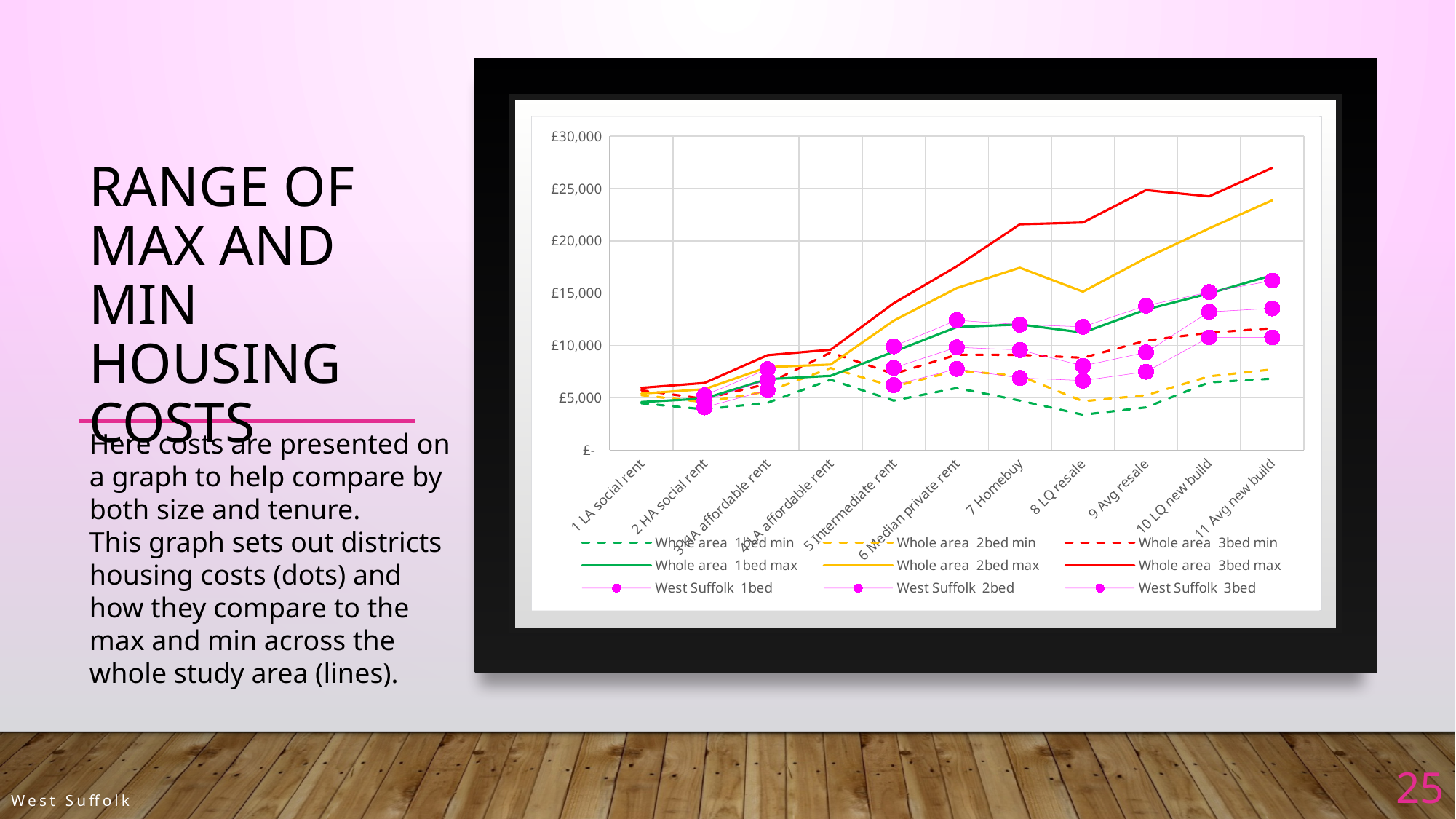
At which category does the Whole area 1bed min line reach its lowest value? 8 LQ resale Is the value of Whole area 3bed max at 7 Homebuy greater or less than £20,000? greater How many series does the chart's legend list? 9 What kind of chart is shown on the slide? Line chart What colour is the Whole area 3bed max line in the chart? Red At which category does the Whole area 3bed max line reach its highest value? 11 Avg new build How many categories are shown along the x axis of the chart? 11 Does the Whole area 3bed max line generally rise or fall from 1 LA social rent to 11 Avg new build? Rise At 11 Avg new build, which is larger: Whole area 3bed max or Whole area 2bed max? Whole area 3bed max Is the value of Whole area 3bed max at 11 Avg new build greater or less than £25,000? greater Is the value of Whole area 1bed min at 8 LQ resale greater or less than £5,000? less